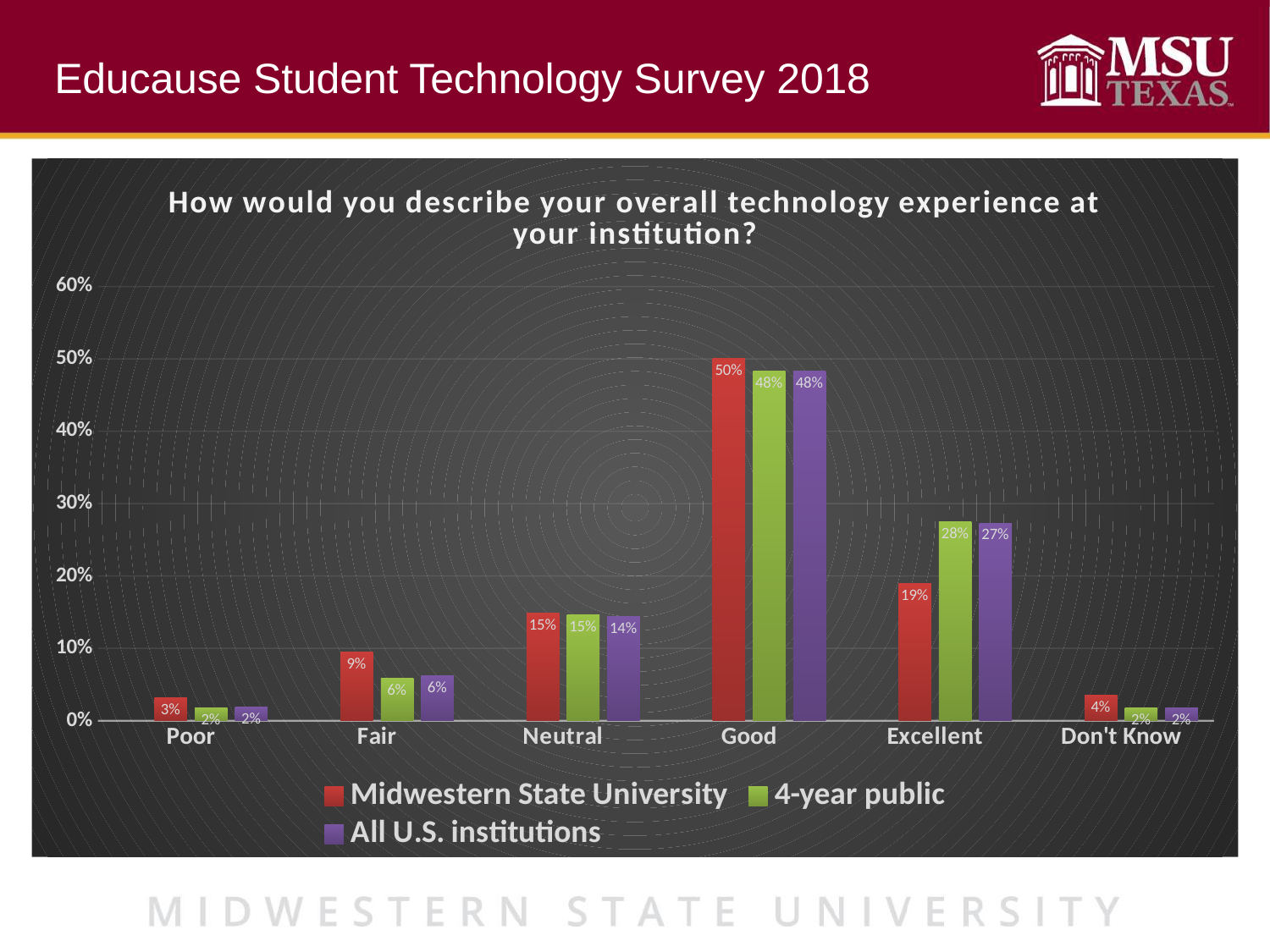
In the Fair category, which is larger: Midwestern State University or All U.S. institutions? Midwestern State University What is the value for 4-year public in the Excellent category? 28% How many categories are shown on the x axis? 6 How many series does the legend list? 3 What is the title of the chart? How would you describe your overall technology experience at your institution? What is the value for Midwestern State University in the Good category? 50% Which category has the lowest value for 4-year public? Poor and Don't Know (both 2%) What is the value for All U.S. institutions in the Neutral category? 14% Which category has the highest value for Midwestern State University? Good What kind of chart is shown on the slide? Bar chart Is the value for All U.S. institutions in the Excellent category greater or less than 20%? greater What is the difference between the Midwestern State University and 4-year public values in the Excellent category? 9%